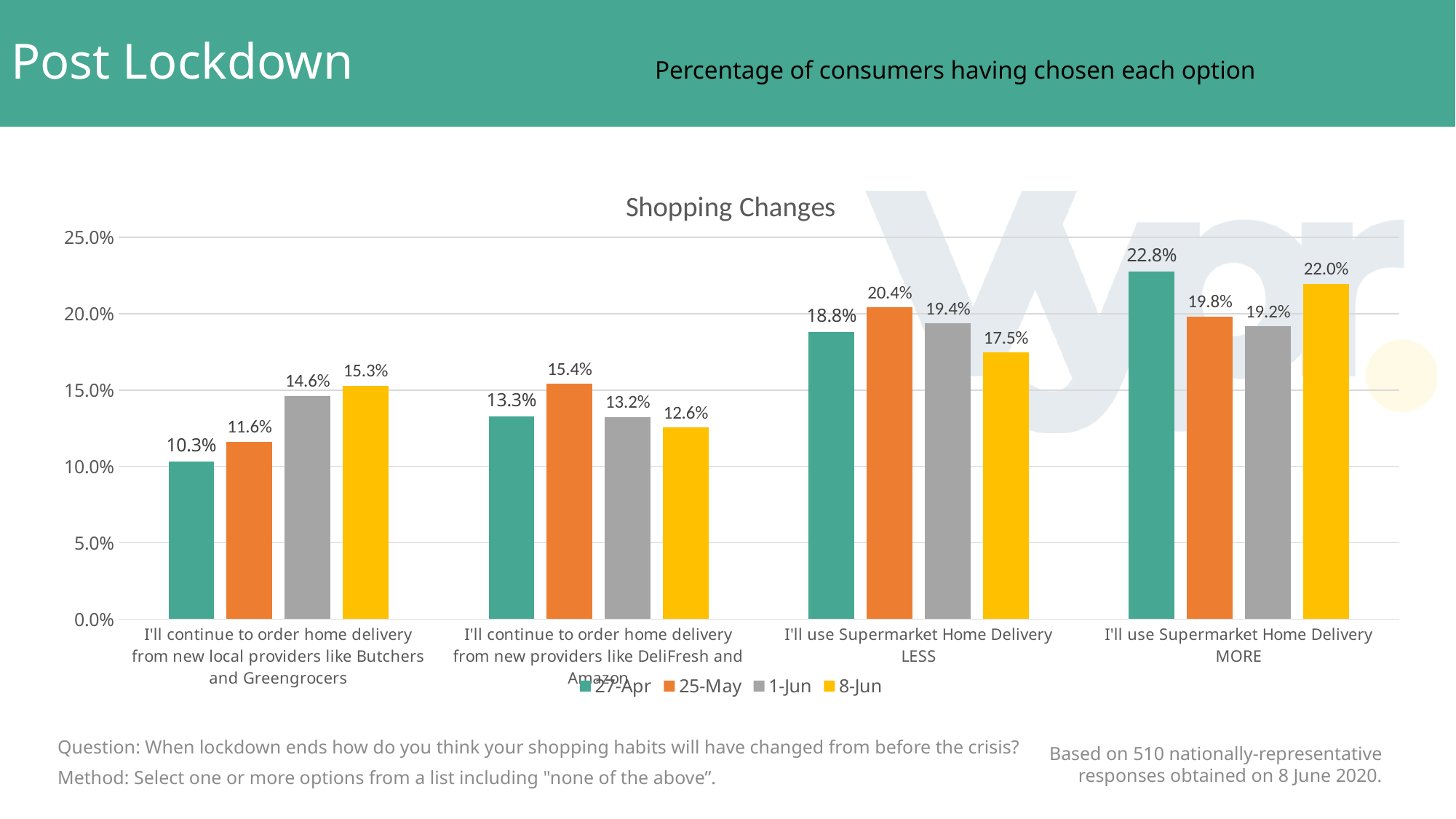
Which category has the highest 27-Apr value? I'll use Supermarket Home Delivery MORE What is the title of the chart? Shopping Changes What is the 8-Jun value for 'I'll use Supermarket Home Delivery MORE'? 22.0% Which is larger for 'I'll use Supermarket Home Delivery LESS': the 25-May value or the 8-Jun value? 25-May What is the 25-May value for 'I'll use Supermarket Home Delivery LESS'? 20.4% What is the 1-Jun value for 'I'll continue to order home delivery from new providers like DeliFresh and Amazon'? 13.2% What kind of chart is shown on the slide? Bar chart What is the difference between the 27-Apr and 8-Jun values for 'I'll continue to order home delivery from new local providers like Butchers and Greengrocers'? 5.0% How many categories are shown on the x axis? 4 Which category has the lowest 8-Jun value? I'll continue to order home delivery from new providers like DeliFresh and Amazon What is the 27-Apr value for 'I'll continue to order home delivery from new local providers like Butchers and Greengrocers'? 10.3% How many series does the legend list? 4